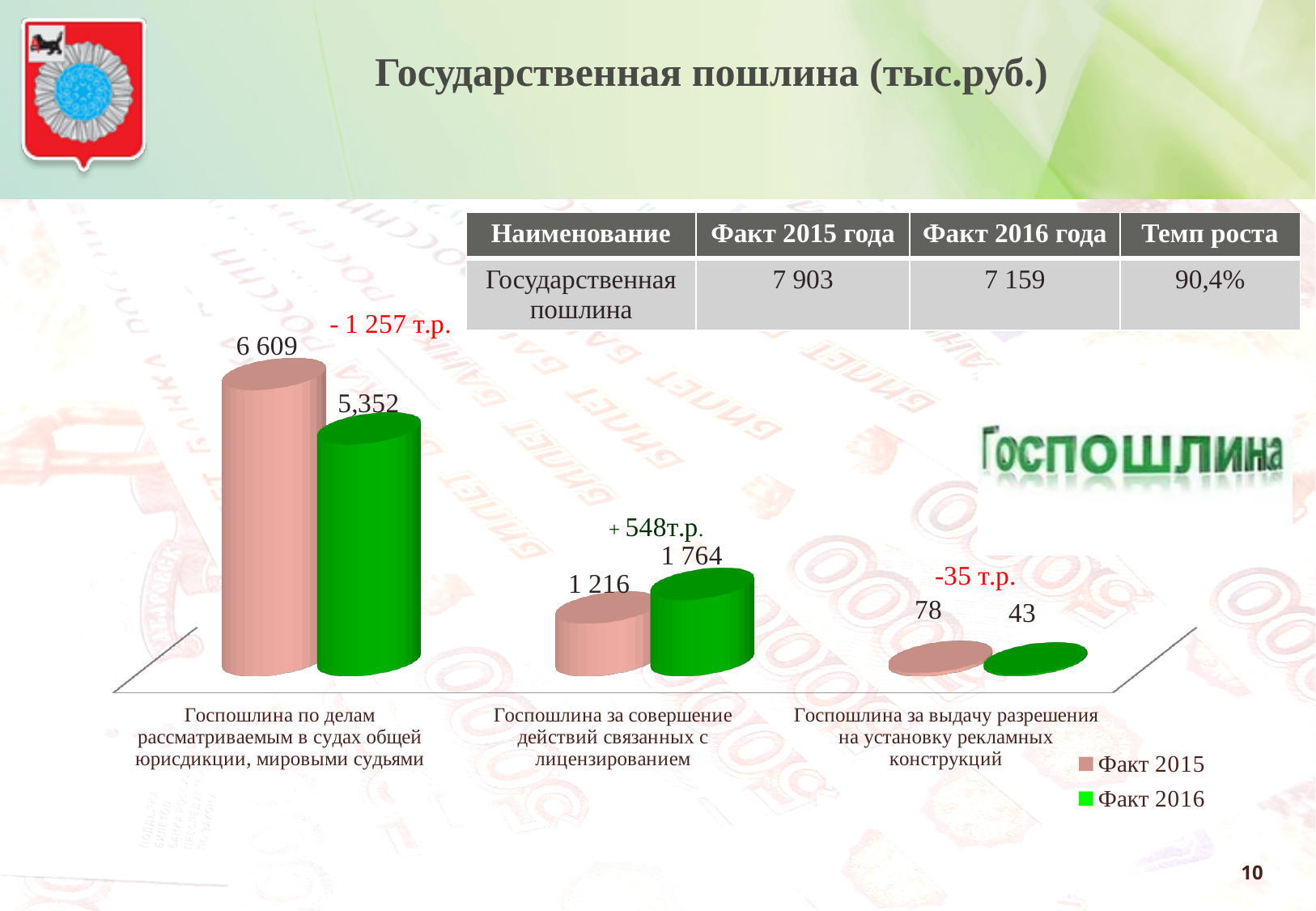
What is the Факт 2016 value for Госпошлина за совершение действий связанных с лицензированием? 1 764 For Госпошлина за выдачу разрешения на установку рекламных конструкций, which is larger: Факт 2015 or Факт 2016? Факт 2015 What is the Факт 2015 value for Госпошлина за совершение действий связанных с лицензированием? 1 216 Which category has the highest Факт 2015 value? Госпошлина по делам рассматриваемым в судах общей юрисдикции, мировыми судьями What is the difference between the Факт 2015 and Факт 2016 values for Госпошлина за совершение действий связанных с лицензированием? 548 What is the Факт 2015 value for Госпошлина по делам рассматриваемым в судах общей юрисдикции, мировыми судьями? 6 609 What is the Факт 2016 value for Госпошлина за выдачу разрешения на установку рекламных конструкций? 43 What is the Факт 2016 value for Госпошлина по делам рассматриваемым в судах общей юрисдикции, мировыми судьями? 5,352 Which category has the lowest Факт 2016 value? Госпошлина за выдачу разрешения на установку рекламных конструкций How many categories are shown on the chart? 3 How many series does the chart legend list? 2 What kind of chart is shown on the slide? Bar chart